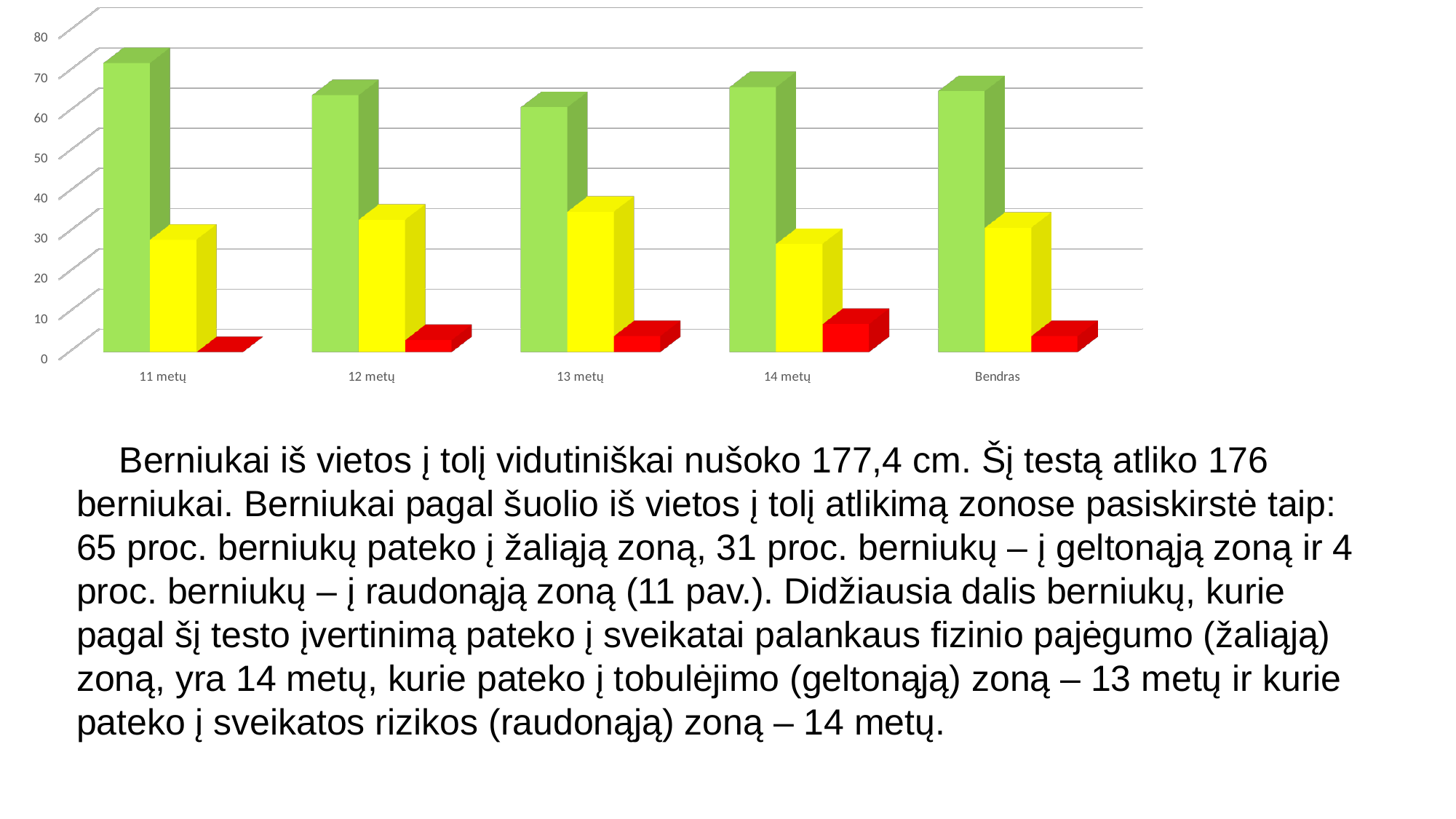
Which is larger, the green bar for 11 metų or the green bar for 13 metų? 11 metų How many bars are shown for each category in the chart? 3 Is the red bar for 14 metų greater or less than 10? less Which category has the shortest green bar? 13 metų In the 11 metų category, which is larger, the green bar or the yellow bar? green bar Is the yellow bar for 12 metų greater or less than 40? less Is the yellow bar for 11 metų greater or less than 20? greater What kind of chart is shown on the slide? bar chart Which category has the tallest red bar? 14 metų How many categories are shown on the x axis of the chart? 5 Which category has the tallest green bar? 11 metų